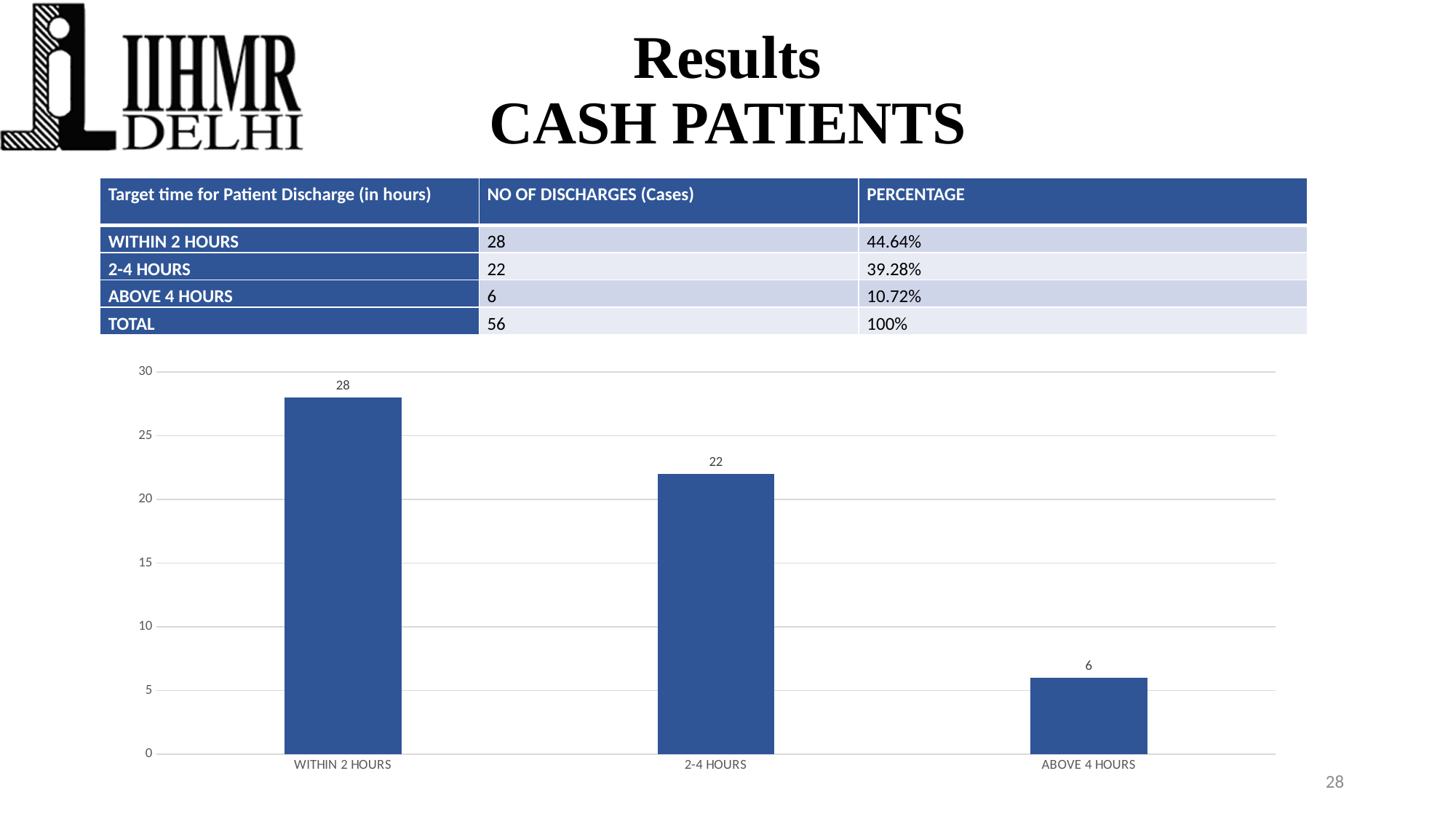
What kind of chart is shown on the slide? bar chart How many categories are shown on the x axis of the bar chart? 3 Which category has the lowest value in the bar chart? ABOVE 4 HOURS Which is larger, the value for 2-4 HOURS or the value for ABOVE 4 HOURS? 2-4 HOURS Which category has the highest value in the bar chart? WITHIN 2 HOURS Is the value for 2-4 HOURS greater or less than 20? greater What is the difference between the values for 2-4 HOURS and ABOVE 4 HOURS? 16 Do the values rise or fall from left to right along the x axis? fall What is the value for WITHIN 2 HOURS in the bar chart? 28 What is the difference between the values for WITHIN 2 HOURS and 2-4 HOURS? 6 What is the value for ABOVE 4 HOURS in the bar chart? 6 What is the value for 2-4 HOURS in the bar chart? 22